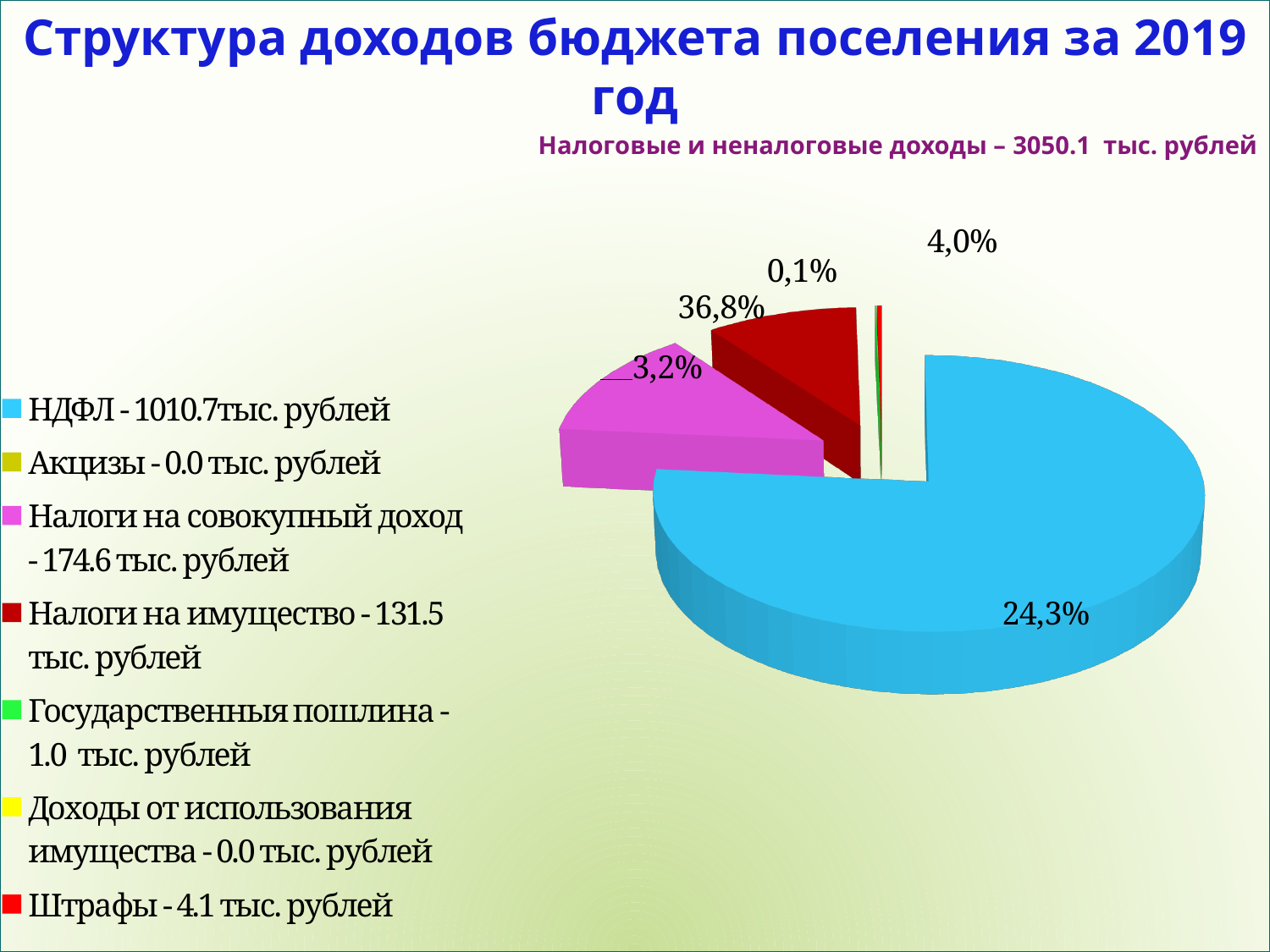
What value does the legend give for Государственныя пошлина? 1.0 тыс. рублей What value does the legend give for НДФЛ? 1010.7 тыс. рублей What kind of chart is shown on the slide? pie chart Which category has the largest slice of the pie chart? НДФЛ What value does the legend give for Штрафы? 4.1 тыс. рублей What is the difference between Налоги на совокупный доход (174.6) and Налоги на имущество (131.5) in тыс. рублей? 43.1 тыс. рублей According to the subtitle, what is the total of tax and non-tax revenues (Налоговые и неналоговые доходы)? 3050.1 тыс. рублей What value does the legend give for Налоги на совокупный доход? 174.6 тыс. рублей Which is larger: Налоги на совокупный доход or Налоги на имущество? Налоги на совокупный доход How many categories does the legend of the pie chart list? 7 What colour is the НДФЛ slice in the pie chart? blue What value does the legend give for Налоги на имущество? 131.5 тыс. рублей